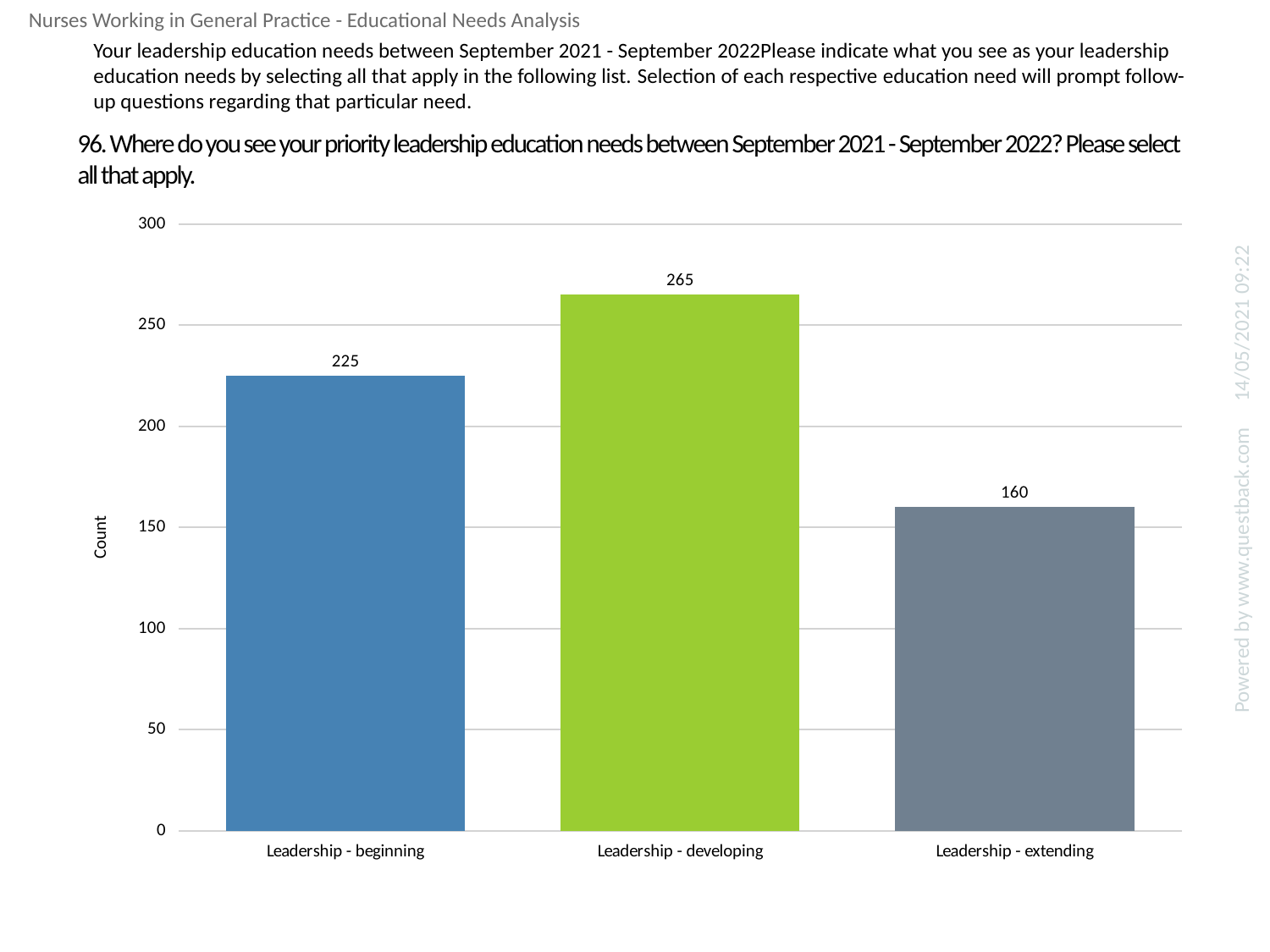
What is the count for Leadership - extending? 160 What kind of chart is shown on the slide? bar chart Is the count for Leadership - developing greater or less than 250? greater What is the difference between the counts for Leadership - developing and Leadership - beginning? 40 What is the label of the y axis? Count Which category has the highest count? Leadership - developing Which has a larger count, Leadership - beginning or Leadership - extending? Leadership - beginning How many categories are shown on the x axis? 3 Which category has the lowest count? Leadership - extending What is the count for Leadership - developing? 265 What is the count for Leadership - beginning? 225 What is the difference between the counts for Leadership - beginning and Leadership - extending? 65